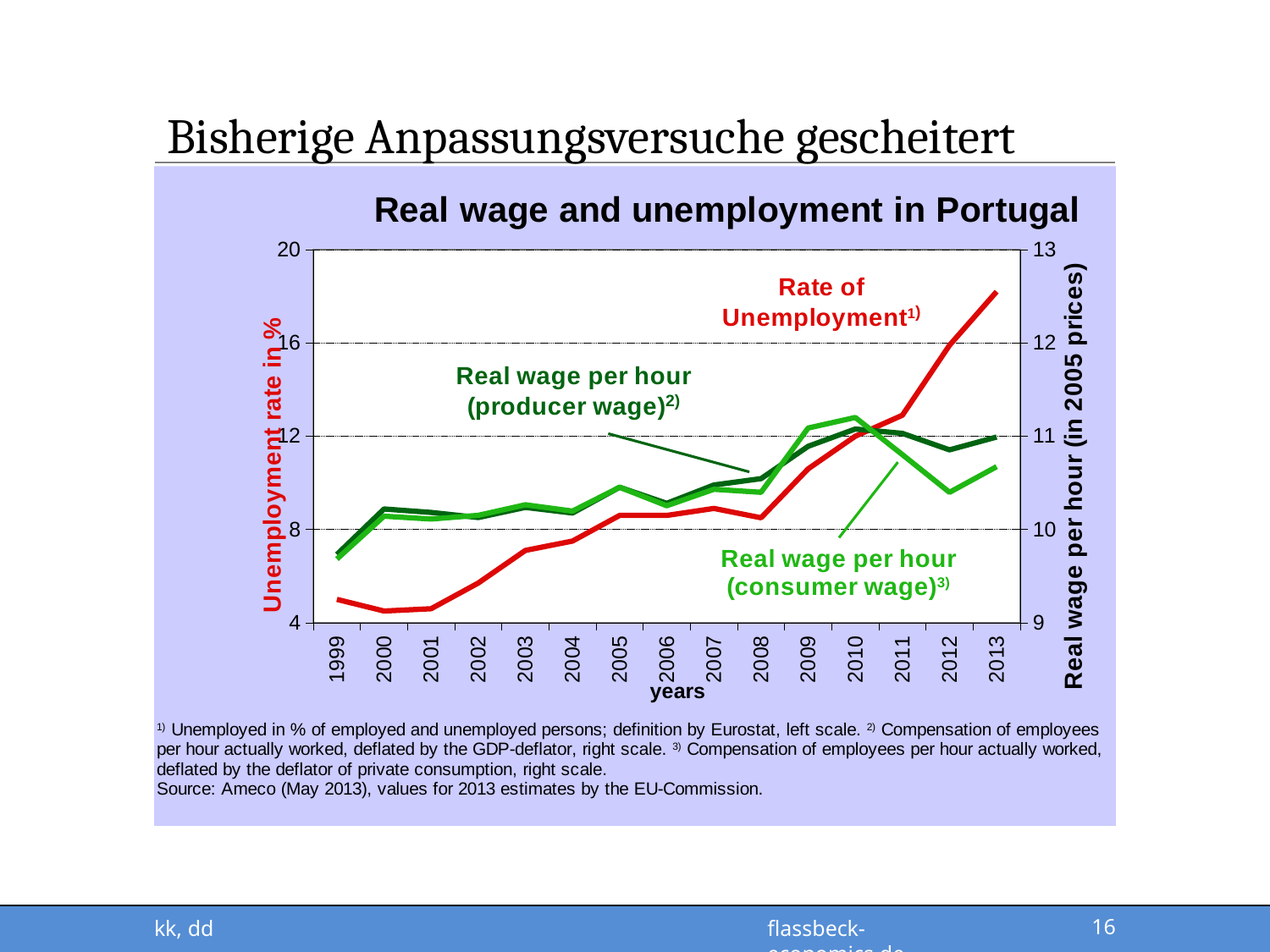
How many years are shown on the x axis of the chart? 15 Does the Rate of Unemployment generally rise or fall from 1999 to 2013? rise What kind of chart is shown on the slide? line chart In which year is the Rate of Unemployment highest? 2013 Which is larger: the Rate of Unemployment in 2013 or in 1999? 2013 Is the Rate of Unemployment in 1999 greater or less than 8? less Is the Rate of Unemployment in 2013 greater or less than 16? greater What is the title of the chart? Real wage and unemployment in Portugal What is the title of the right-hand vertical axis? Real wage per hour (in 2005 prices) Is the Real wage per hour (consumer wage) in 2012 greater or less than 11 on the right scale? less How many series are plotted in the chart? 3